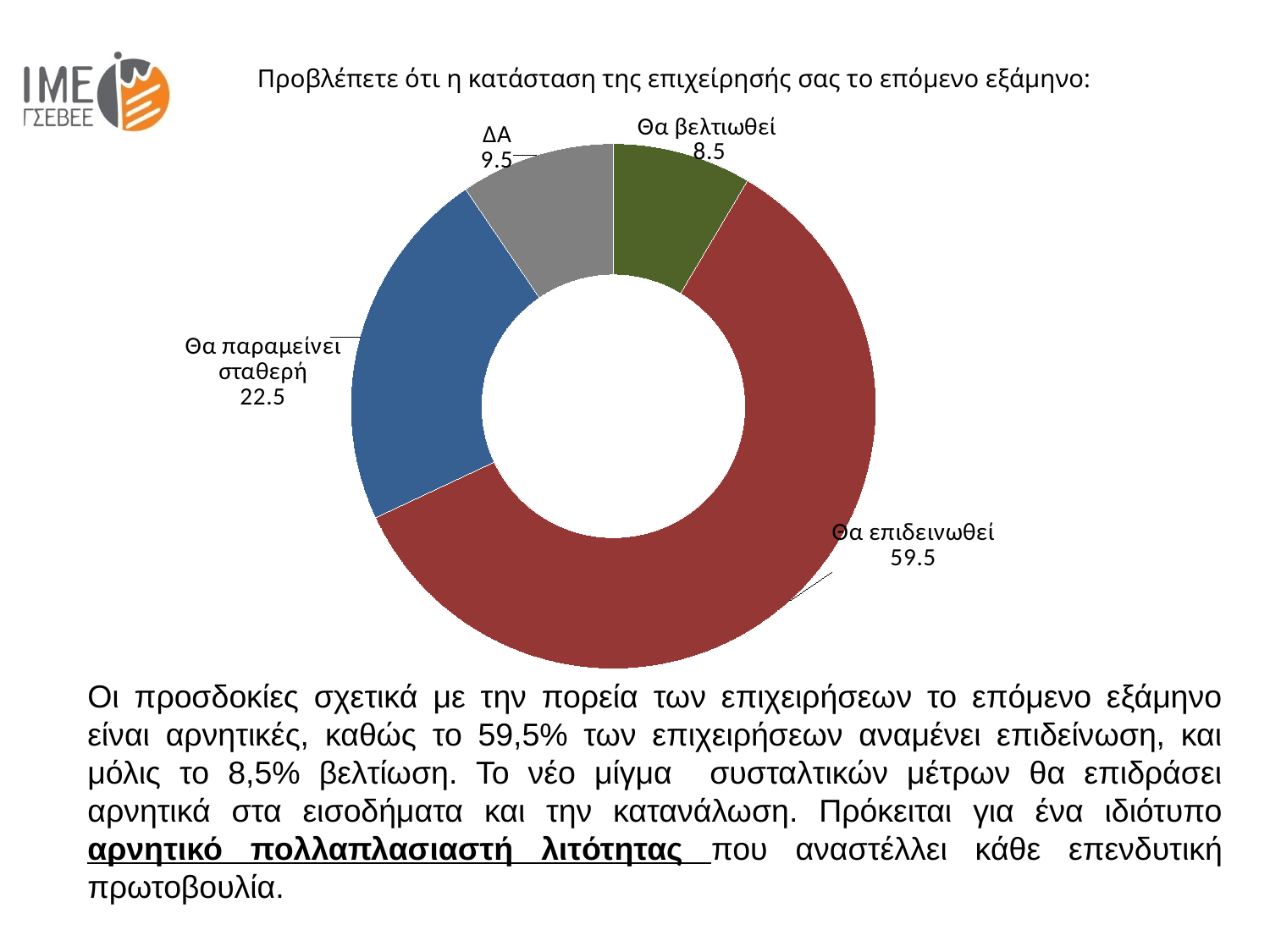
What is the difference between the values for 'Θα επιδεινωθεί' and 'Θα παραμείνει σταθερή'? 37 Which category has the largest slice? Θα επιδεινωθεί What kind of chart is shown on the slide? Doughnut (pie) chart What value is shown for the 'Θα επιδεινωθεί' slice? 59.5 Which is larger, the value for 'Θα παραμείνει σταθερή' or the value for 'ΔΑ'? Θα παραμείνει σταθερή What value is shown for the 'ΔΑ' slice? 9.5 Which category has the smallest slice? Θα βελτιωθεί What is the difference between the values for 'ΔΑ' and 'Θα βελτιωθεί'? 1 What value is shown for the 'Θα βελτιωθεί' slice? 8.5 How many categories are shown in the chart? 4 What is the title of the chart? Προβλέπετε ότι η κατάσταση της επιχείρησής σας το επόμενο εξάμηνο: What value is shown for the 'Θα παραμείνει σταθερή' slice? 22.5